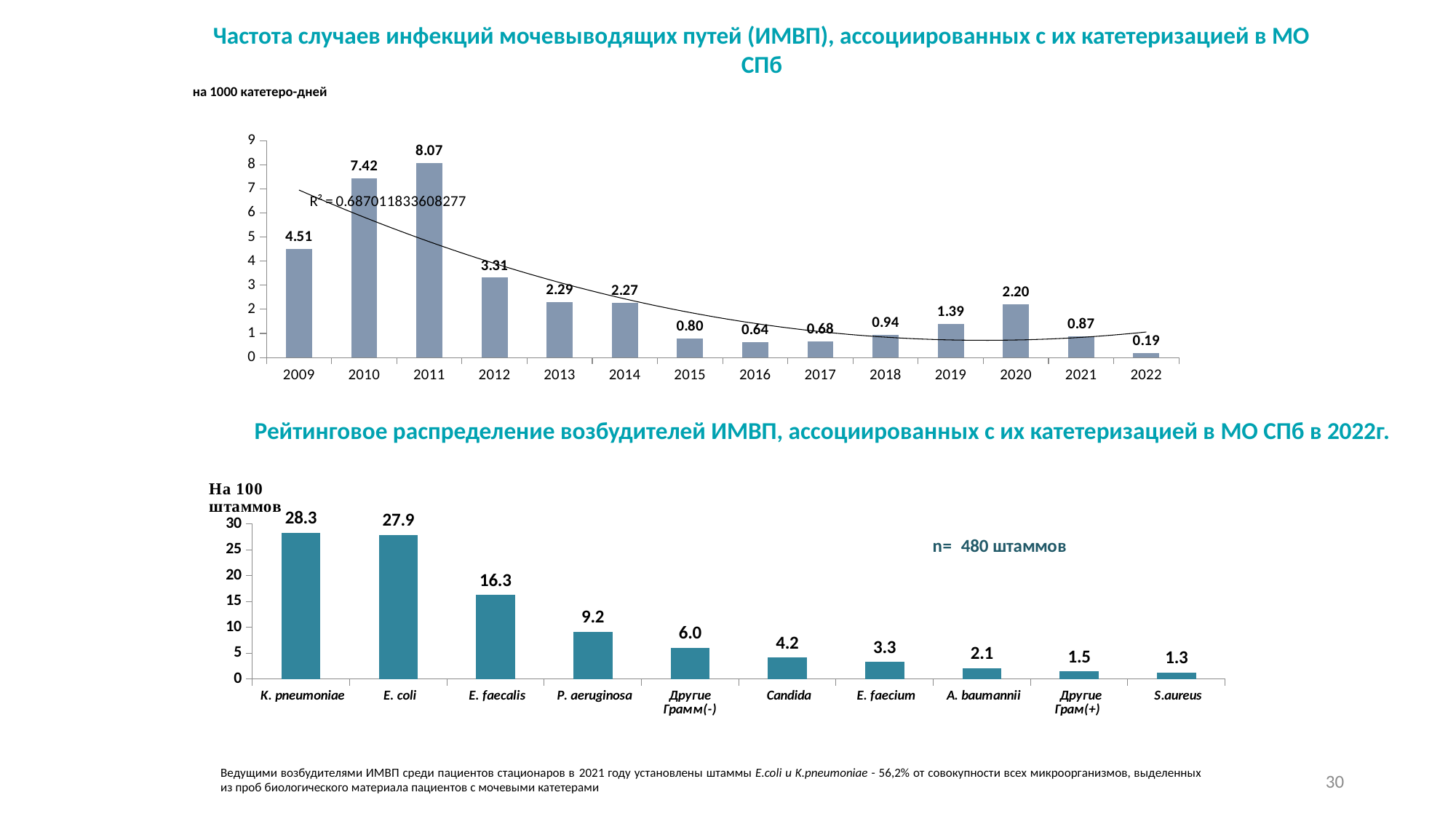
In the top chart (Частота случаев инфекций мочевыводящих путей), what is the difference between the values for 2010 and 2009? 2.91 In the bottom chart (Рейтинговое распределение возбудителей ИМВП), what is the value for E. faecalis? 16.3 In the top chart (Частота случаев инфекций мочевыводящих путей), is the value for 2020 larger than the value for 2019? Yes, 2020 (2.20) In the bottom chart (Рейтинговое распределение возбудителей ИМВП), which category has the lowest value? S.aureus In the top chart (Частота случаев инфекций мочевыводящих путей), what is the value for 2011? 8.07 In the top chart (Частота случаев инфекций мочевыводящих путей), which year has the highest value? 2011 What type of chart is the bottom chart (Рейтинговое распределение возбудителей ИМВП)? Bar chart In the top chart (Частота случаев инфекций мочевыводящих путей), how many years are shown on the x axis? 14 In the top chart (Частота случаев инфекций мочевыводящих путей), which year has the lowest value? 2022 In the bottom chart (Рейтинговое распределение возбудителей ИМВП), which pathogen has the highest value? K. pneumoniae In the top chart (Частота случаев инфекций мочевыводящих путей), do the values generally rise or fall from 2011 to 2017? Fall In the bottom chart (Рейтинговое распределение возбудителей ИМВП), how many categories are shown? 10